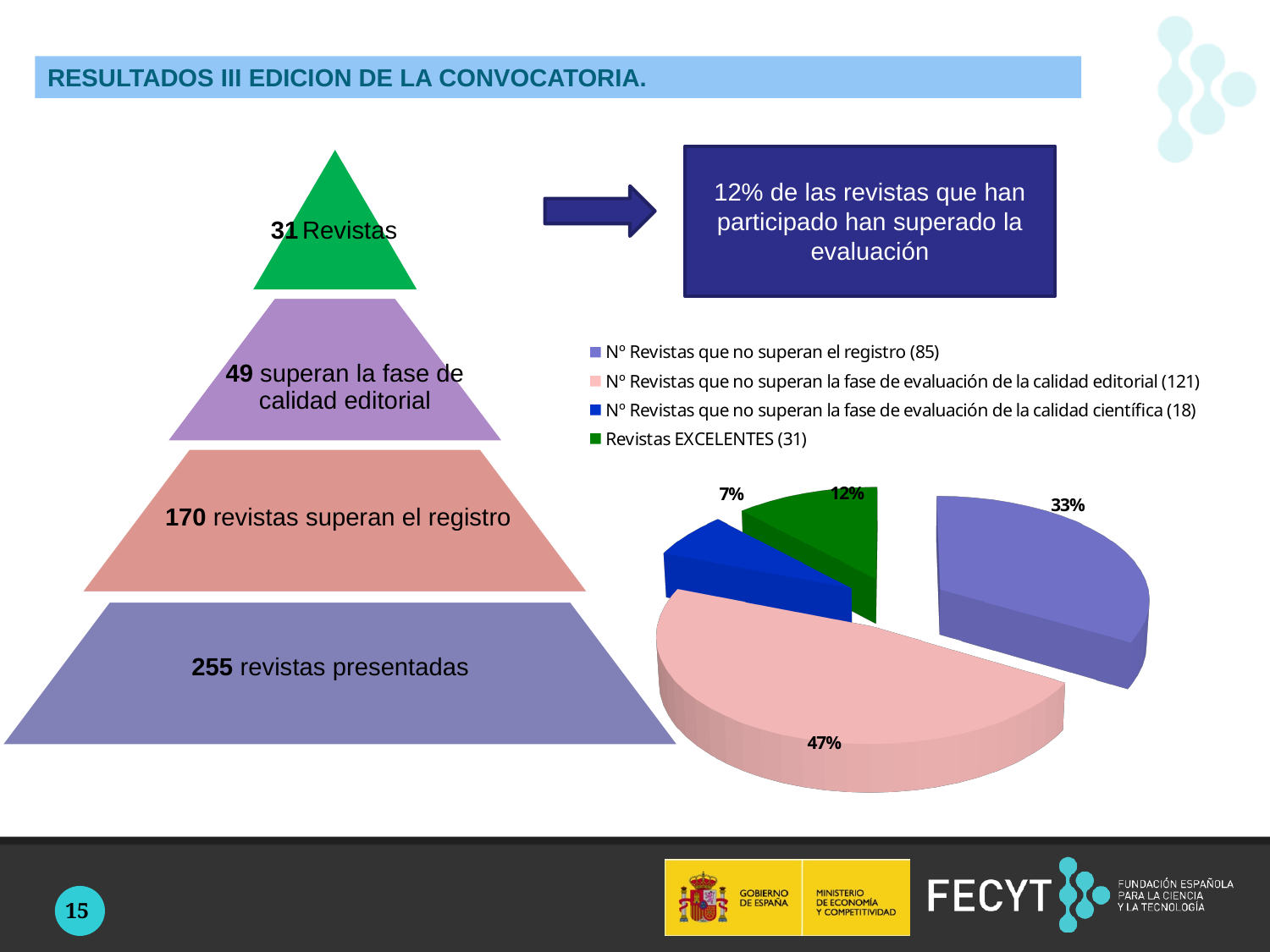
What is the difference in percentage points between the 47% slice and the 33% slice? 14 What percentage of the pie corresponds to 'Revistas EXCELENTES'? 12% What percentage of the pie corresponds to 'Nº Revistas que no superan la fase de evaluación de la calidad científica'? 7% What colour is the slice for 'Revistas EXCELENTES' in the pie chart? green How many slices does the pie chart have? 4 What percentage of the pie corresponds to 'Nº Revistas que no superan la fase de evaluación de la calidad editorial'? 47% Which category has the largest slice of the pie chart? Nº Revistas que no superan la fase de evaluación de la calidad editorial Which slice is larger: 'Revistas EXCELENTES' or 'Nº Revistas que no superan la fase de evaluación de la calidad científica'? Revistas EXCELENTES How many entries does the pie chart's legend list? 4 Which category has the smallest slice of the pie chart? Nº Revistas que no superan la fase de evaluación de la calidad científica What kind of chart is shown on the slide? pie chart